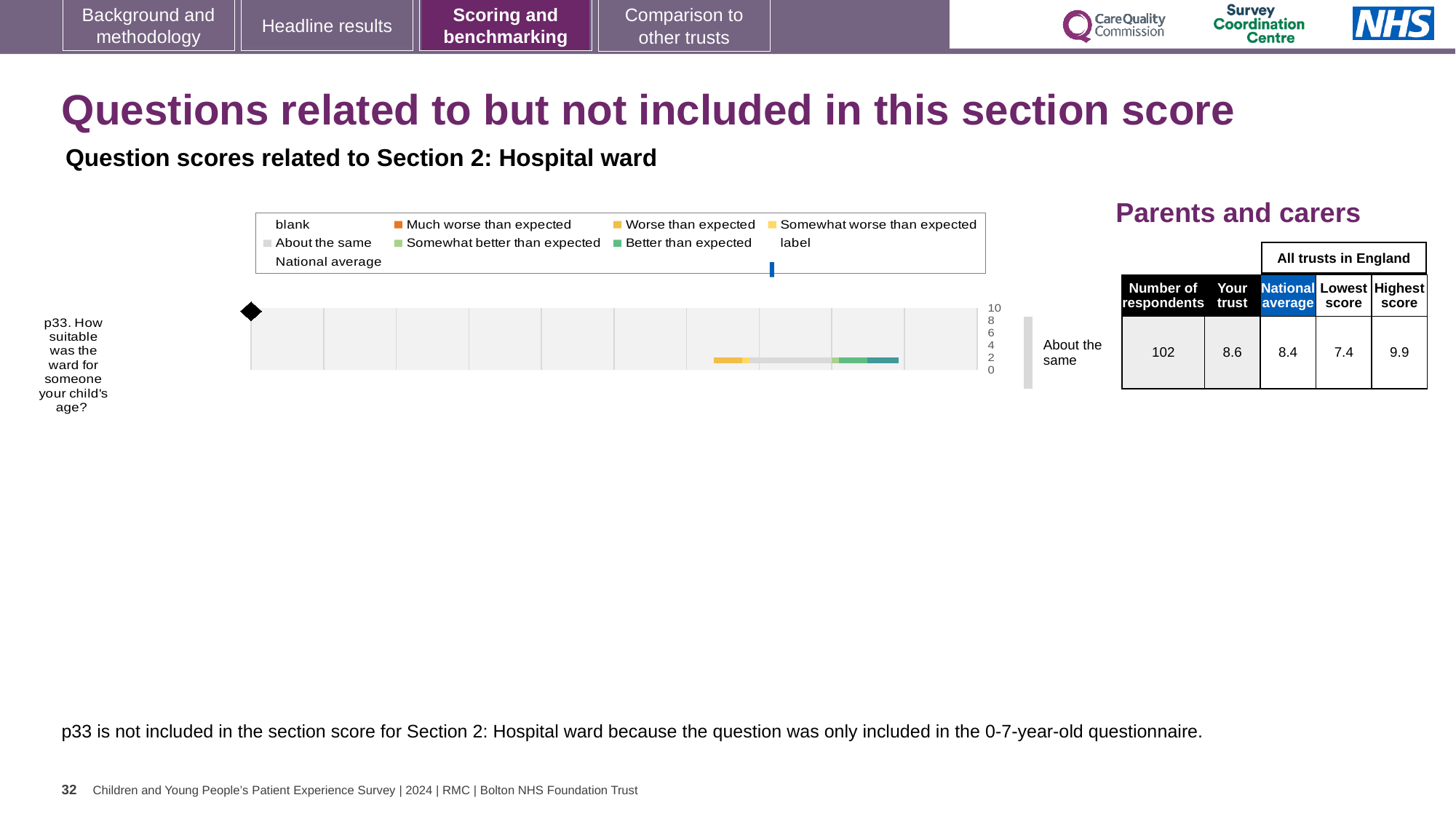
How many questions are plotted in the chart? 1 What is the lowest score among all trusts in England for p33? 7.4 Which is larger for p33, the 'Your trust' score or the national average? Your trust What is the difference between the 'Your trust' score and the national average for p33? 0.2 What kind of chart is used to show the benchmarking result for question p33? Bar chart What is the 'Your trust' score for p33? 8.6 Which question is plotted in the chart? p33. How suitable was the ward for someone your child's age? What is the highest score among all trusts in England for p33? 9.9 What benchmarking category label is shown next to the bar for p33? About the same What is the difference between the highest and lowest scores for p33? 2.5 How many respondents answered p33? 102 What is the national average score for p33? 8.4